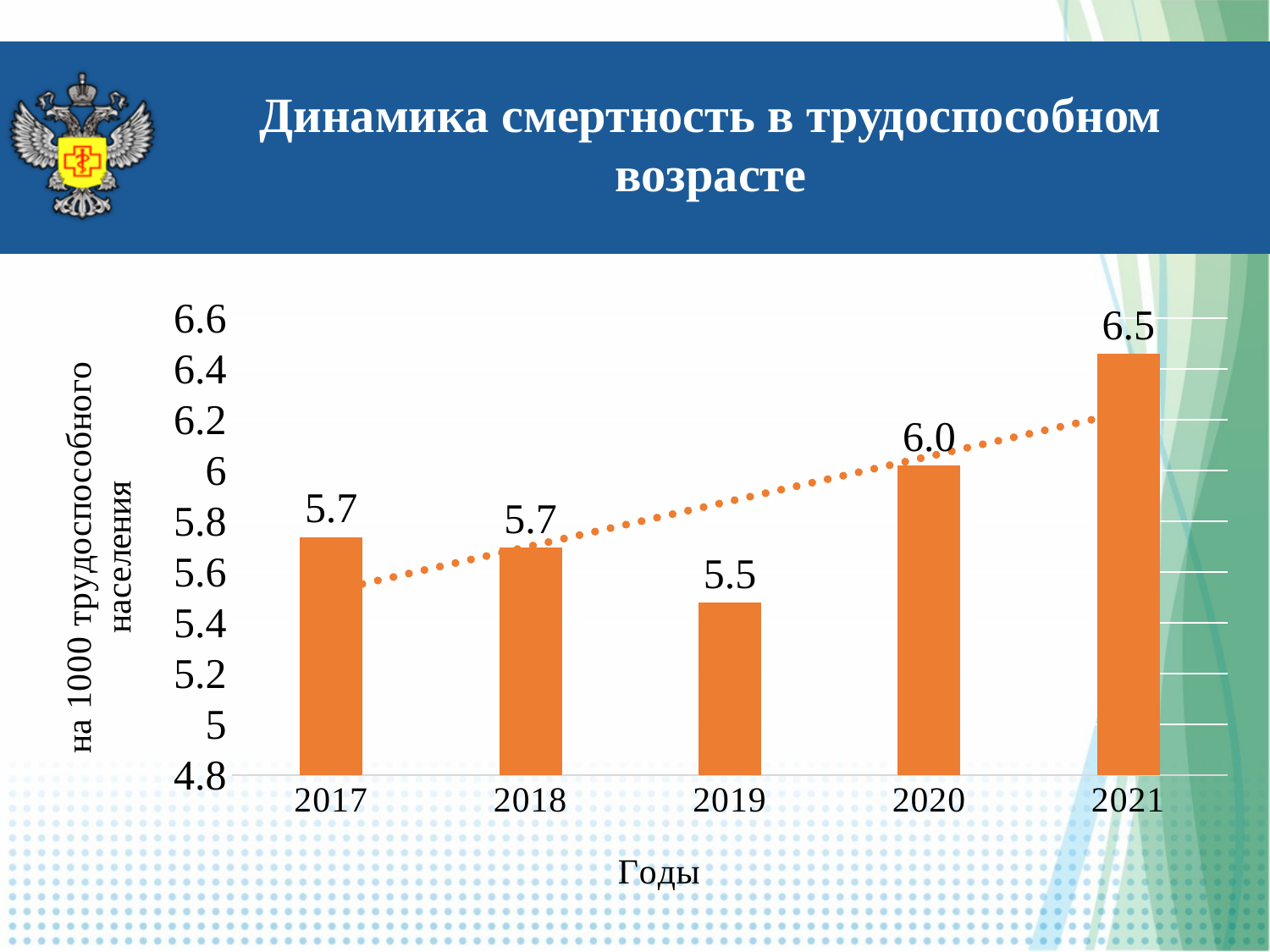
Is the value for 2021 greater or less than 6.2? greater What is the difference between the values for 2021 and 2019? 1.0 How many years are shown on the x axis? 5 Which is larger, the value for 2020 or the value for 2019? 2020 What is the value for 2021? 6.5 Which year has the lowest value? 2019 What is the value for 2019? 5.5 What is the value for 2020? 6.0 Do the values rise or fall from 2019 to 2021? rise What kind of chart is this? bar chart Which year has the highest value? 2021 What is the label of the x axis? Годы